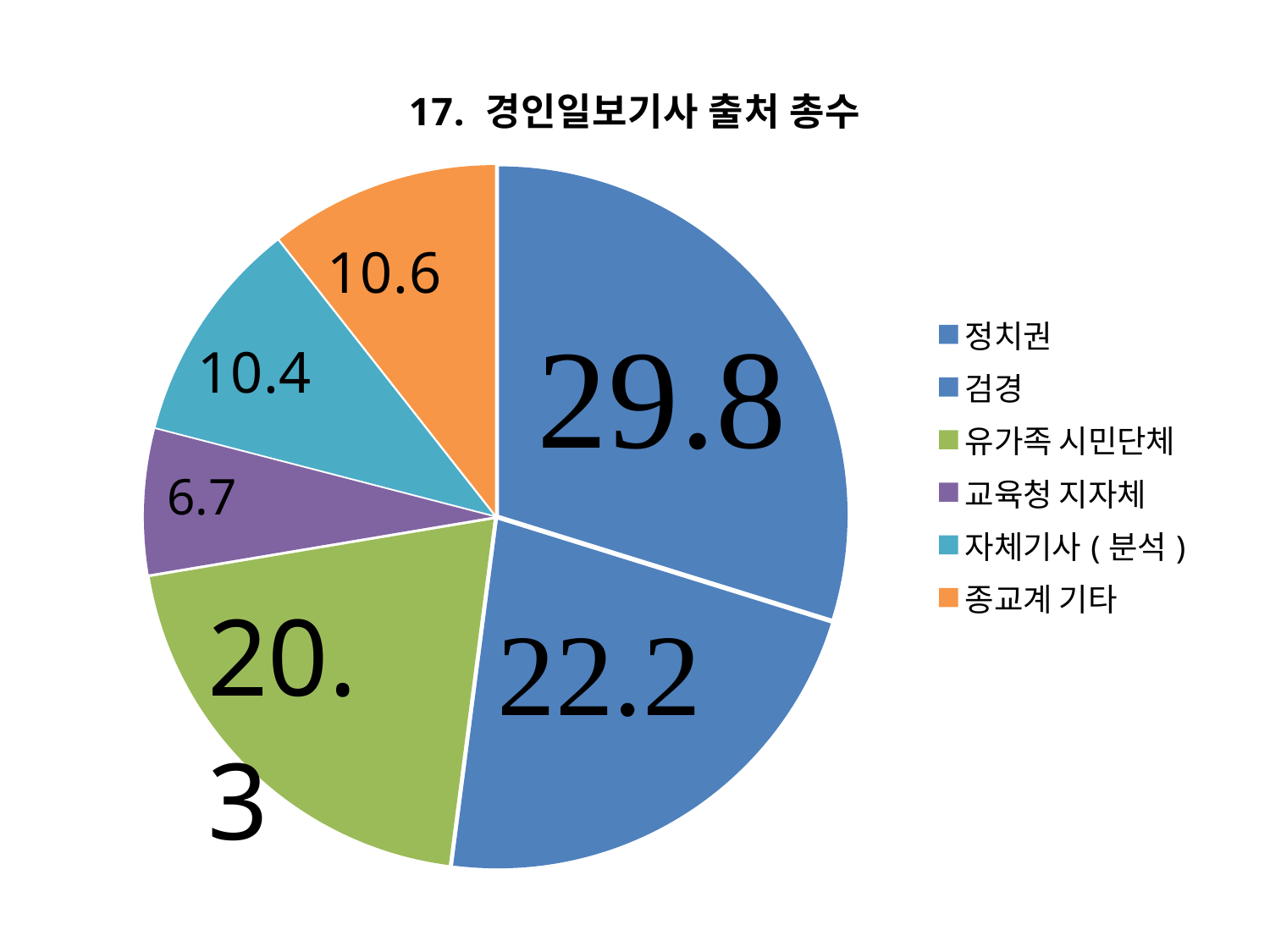
What is the difference between the values for 종교계 기타 and 자체기사 ( 분석 )? 0.2 What kind of chart is shown on the slide? pie chart Which category has the largest slice? 정치권 What is the value for 자체기사 ( 분석 )? 10.4 Which is larger, the value for 검경 or the value for 유가족 시민단체? 검경 What is the value for 교육청 지자체? 6.7 What is the value for 정치권? 29.8 How many slices does the pie chart have? 6 What is the title of the chart? 17. 경인일보기사 출처 총수 Which category has the smallest slice? 교육청 지자체 What is the value for 유가족 시민단체? 20.3 What is the value for 종교계 기타? 10.6